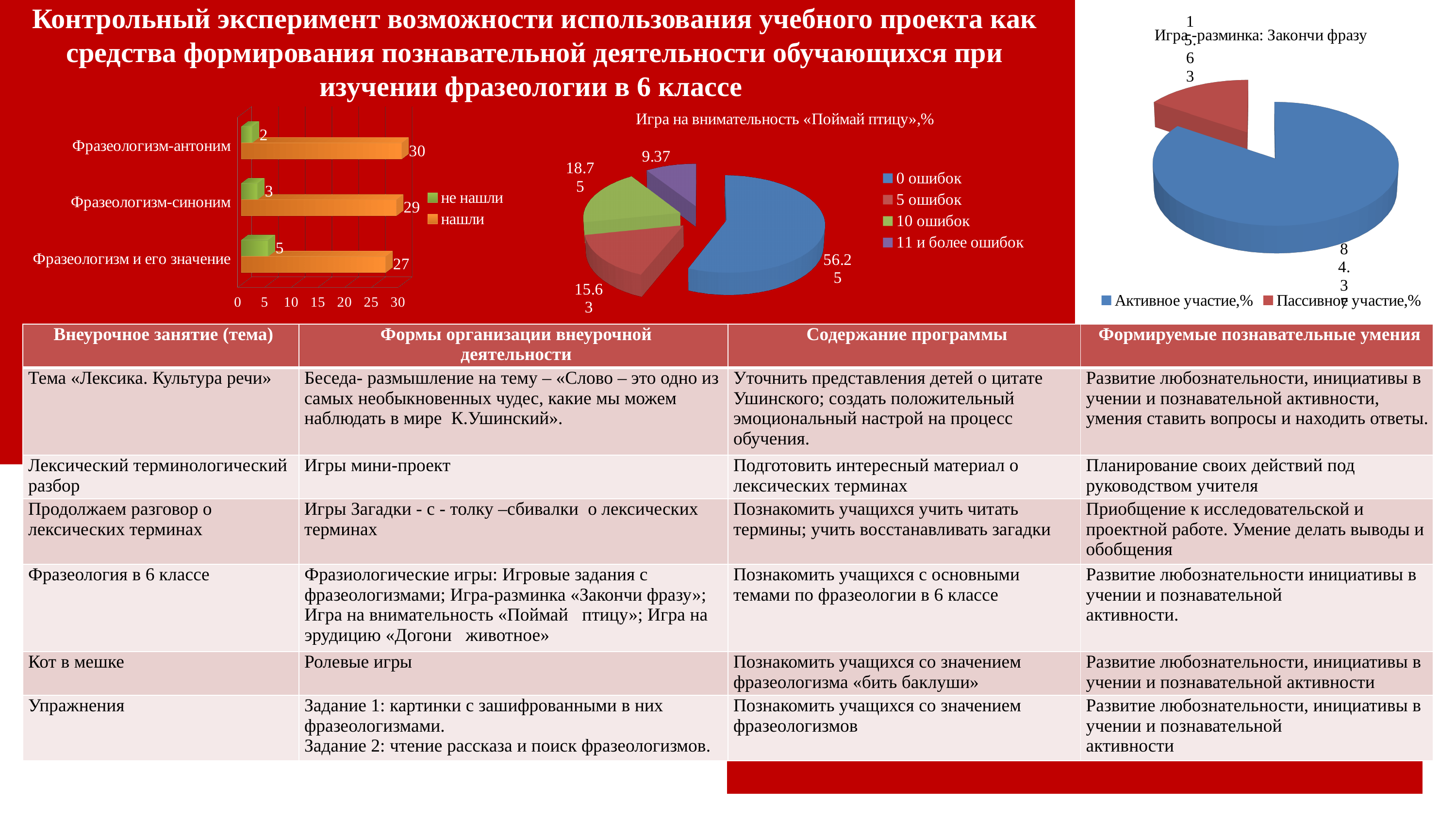
On the left bar chart, what is the difference between «нашли» and «не нашли» for Фразеологизм-синоним? 26 On the pie chart «Игра на внимательность «Поймай птицу»,%», which category has the smallest slice? 11 и более ошибок On the pie chart «Игра на внимательность «Поймай птицу»,%», what is the value for 11 и более ошибок? 9.37 On the left bar chart, which category has the lowest «не нашли» value? Фразеологизм-антоним On the left bar chart, what is the value of «не нашли» for Фразеологизм и его значение? 5 On the left bar chart, how many series does the legend list? 2 On the pie chart «Игра на внимательность «Поймай птицу»,%», what is the value for 0 ошибок? 56.25 On the left bar chart, what is the value of «нашли» for Фразеологизм-антоним? 30 What kind of chart is the left chart with «нашли» and «не нашли»? Bar chart On the pie chart «Игра-разминка: Закончи фразу», which is larger: Активное участие,% or Пассивное участие,%? Активное участие,% On the pie chart «Игра на внимательность «Поймай птицу»,%», how many categories does the legend list? 4 On the left bar chart, which category has the highest «нашли» value? Фразеологизм-антоним